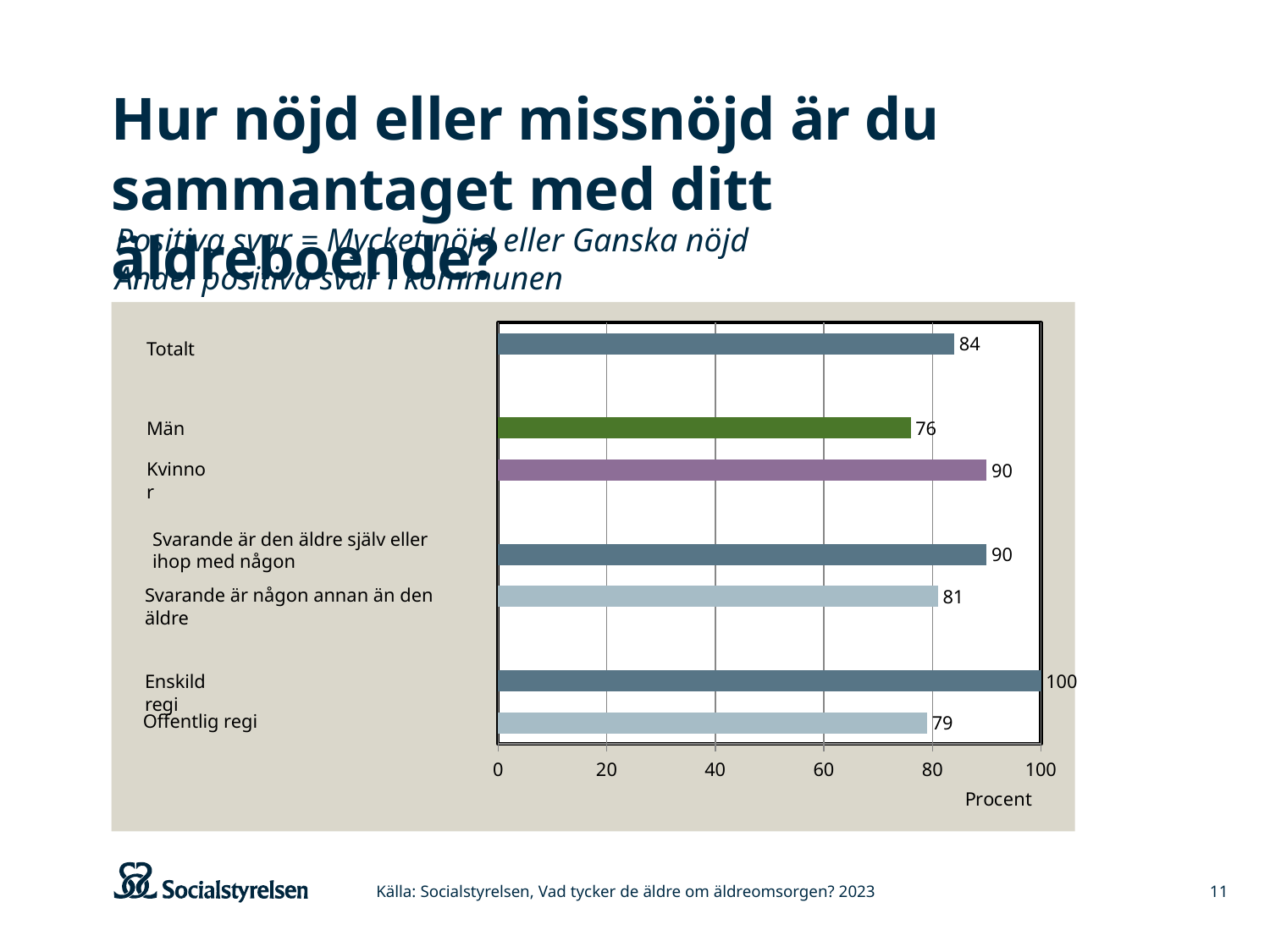
Which is larger, the value for Totalt or the value for Svarande är någon annan än den äldre? Totalt How many categories are shown in the chart? 7 What is the value for Kvinnor? 90 What is the difference between the values for Enskild regi and Offentlig regi? 21 Which category has the lowest value? Män What is the difference between the values for Kvinnor and Män? 14 What is the value for Offentlig regi? 79 What is the value for Totalt? 84 What kind of chart is shown on the slide? Bar chart What is the value for Svarande är någon annan än den äldre? 81 Which category has the highest value? Enskild regi What is the value for Män? 76